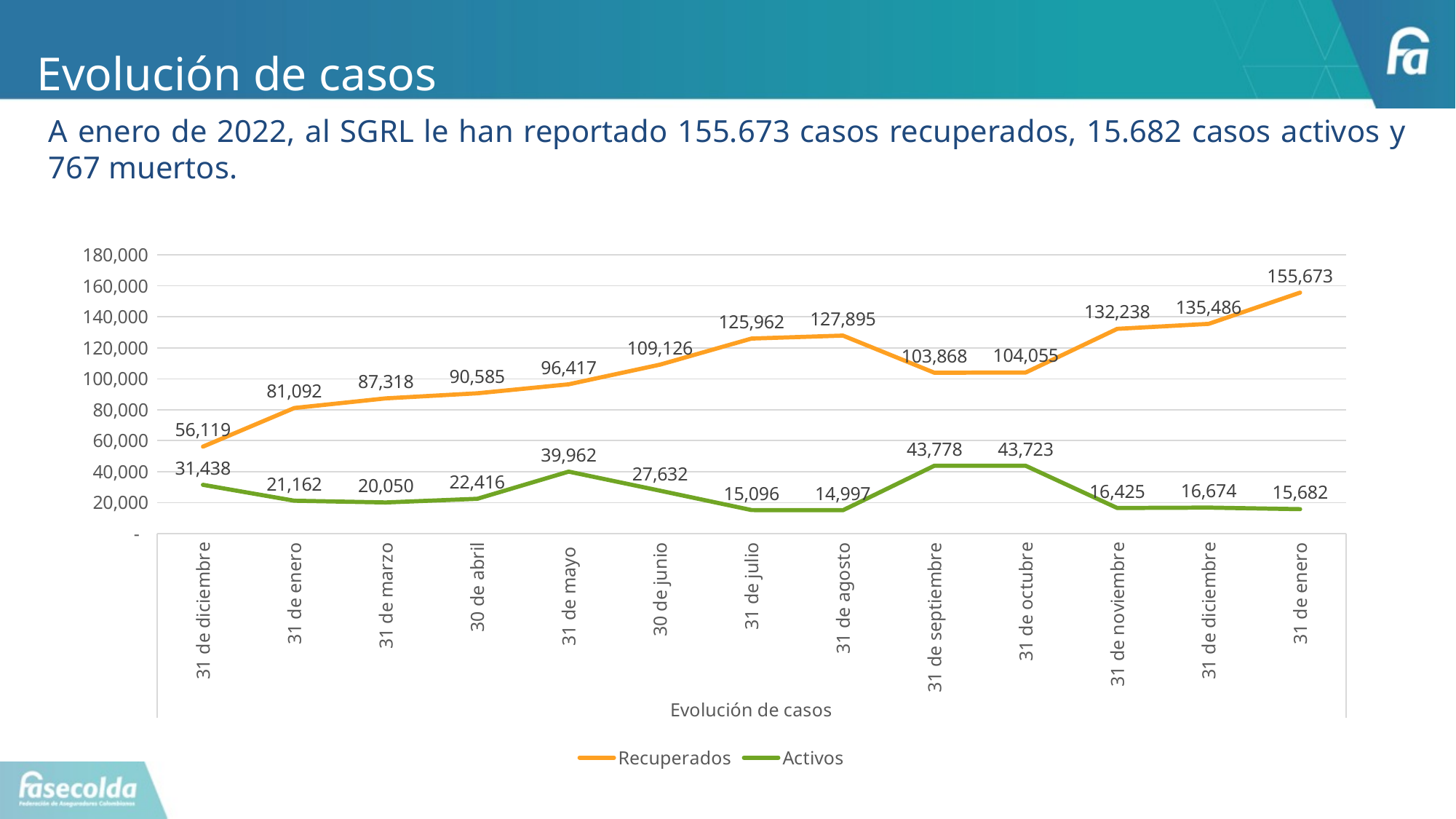
On which date is the Recuperados series at its lowest? 31 de diciembre (first point) What is the value of Activos on 31 de mayo? 39,962 What is the value of Recuperados on 30 de junio? 109,126 What is the value of Recuperados on 31 de enero (the last point)? 155,673 How many series does the legend list? 2 What type of chart is shown on the slide? line chart Does the Recuperados series generally rise or fall from 31 de diciembre to 31 de enero? rise On which date is the Activos series at its highest? 31 de septiembre Which series is drawn in orange? Recuperados How many dates are plotted along the x axis? 13 What is the difference between Recuperados and Activos on 31 de agosto? 112,898 Which is larger: Activos on 31 de septiembre or Activos on 31 de octubre? 31 de septiembre